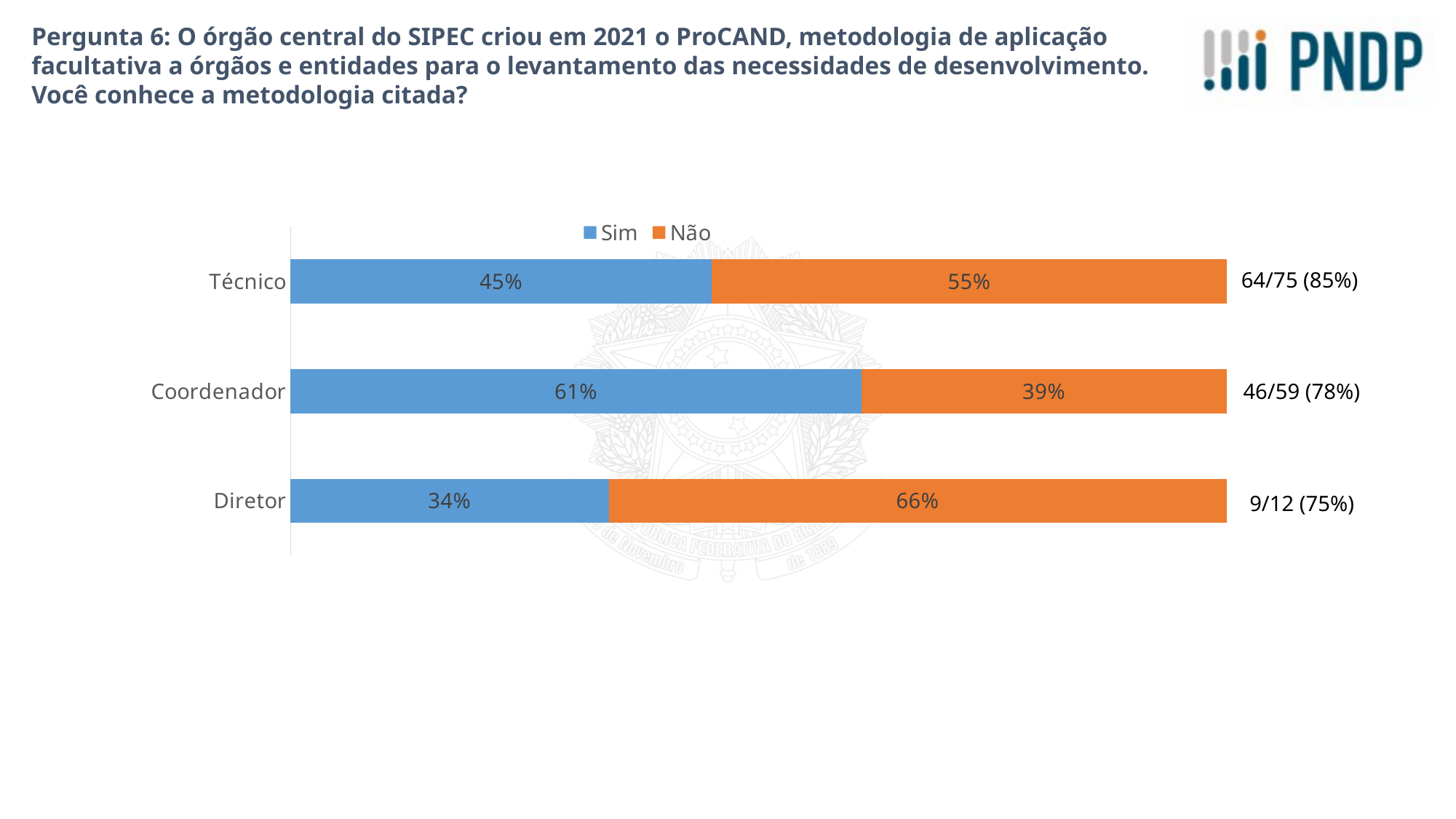
What is the total of the stacked bar for Coordenador? 100% What is the 'Sim' value for Técnico? 45% Which category has the lowest 'Sim' value? Diretor What response count annotation is shown next to the Técnico bar? 64/75 (85%) What is the 'Sim' value for Coordenador? 61% How many categories are shown on the chart? 3 What is the 'Não' value for Diretor? 66% Which is larger for Técnico, the 'Sim' value or the 'Não' value? Não What kind of chart is shown on the slide? Stacked bar chart Which category has the highest 'Sim' value? Coordenador What is the difference between the 'Não' values for Diretor and Coordenador? 27% How many series does the legend list? 2